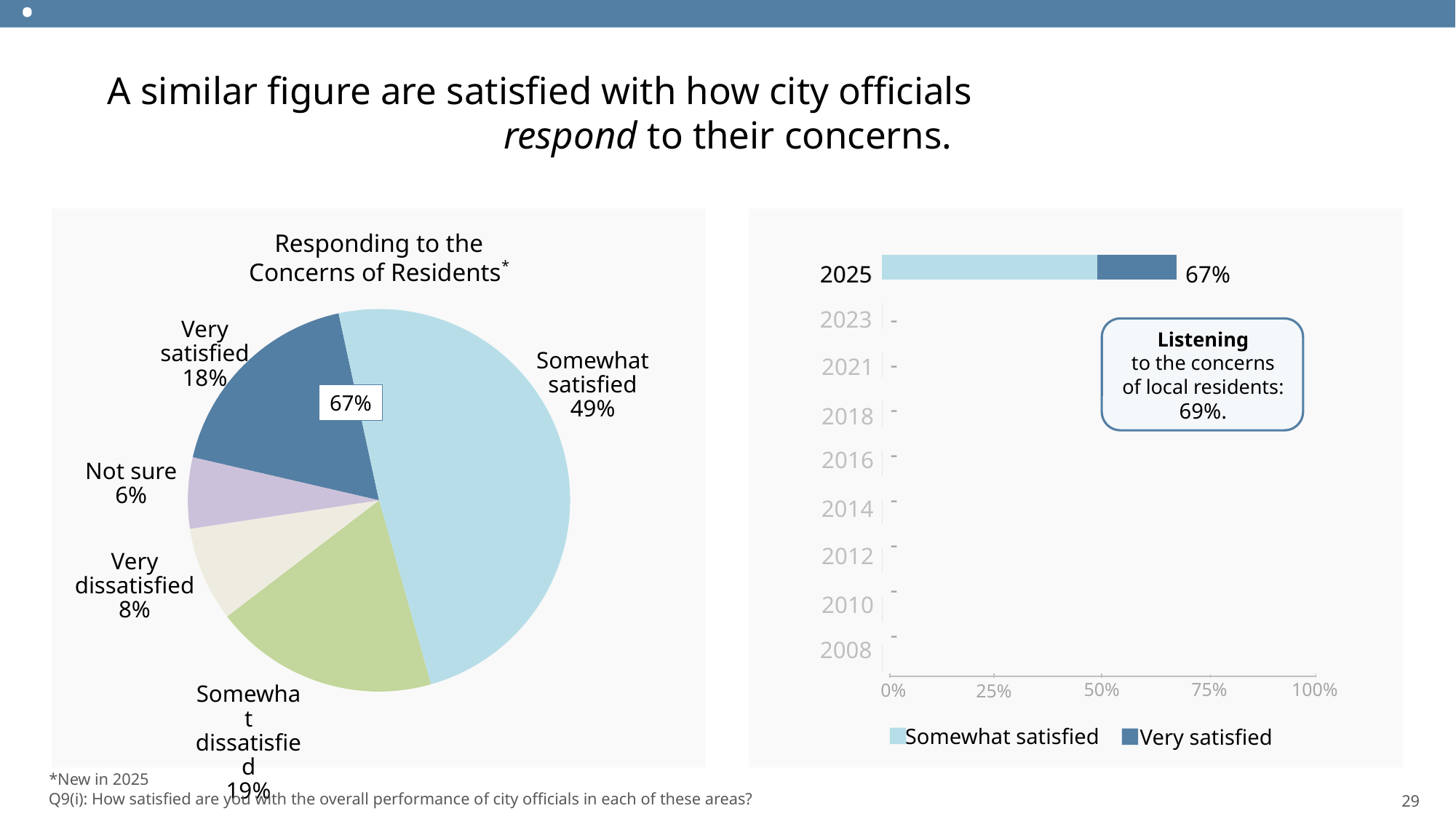
In the pie chart titled "Responding to the Concerns of Residents", what percentage of respondents are very satisfied? 18% In the bar chart on the right, what is the total satisfied percentage labelled for 2025? 67% In the bar chart on the right, is the total value for 2025 greater or less than 50%? greater How many series does the legend of the bar chart on the right list? 2 How many slices does the pie chart titled "Responding to the Concerns of Residents" have? 5 In the pie chart titled "Responding to the Concerns of Residents", what percentage of respondents are somewhat satisfied? 49% What type of chart is the chart on the right side of the slide? Bar chart In the pie chart titled "Responding to the Concerns of Residents", which category has the smallest slice? Not sure In the pie chart titled "Responding to the Concerns of Residents", which category has the largest slice? Somewhat satisfied In the pie chart titled "Responding to the Concerns of Residents", what percentage of respondents are somewhat dissatisfied? 19% In the pie chart titled "Responding to the Concerns of Residents", which is larger: very dissatisfied or not sure? Very dissatisfied In the pie chart titled "Responding to the Concerns of Residents", what is the difference between the somewhat satisfied and very satisfied percentages? 31%